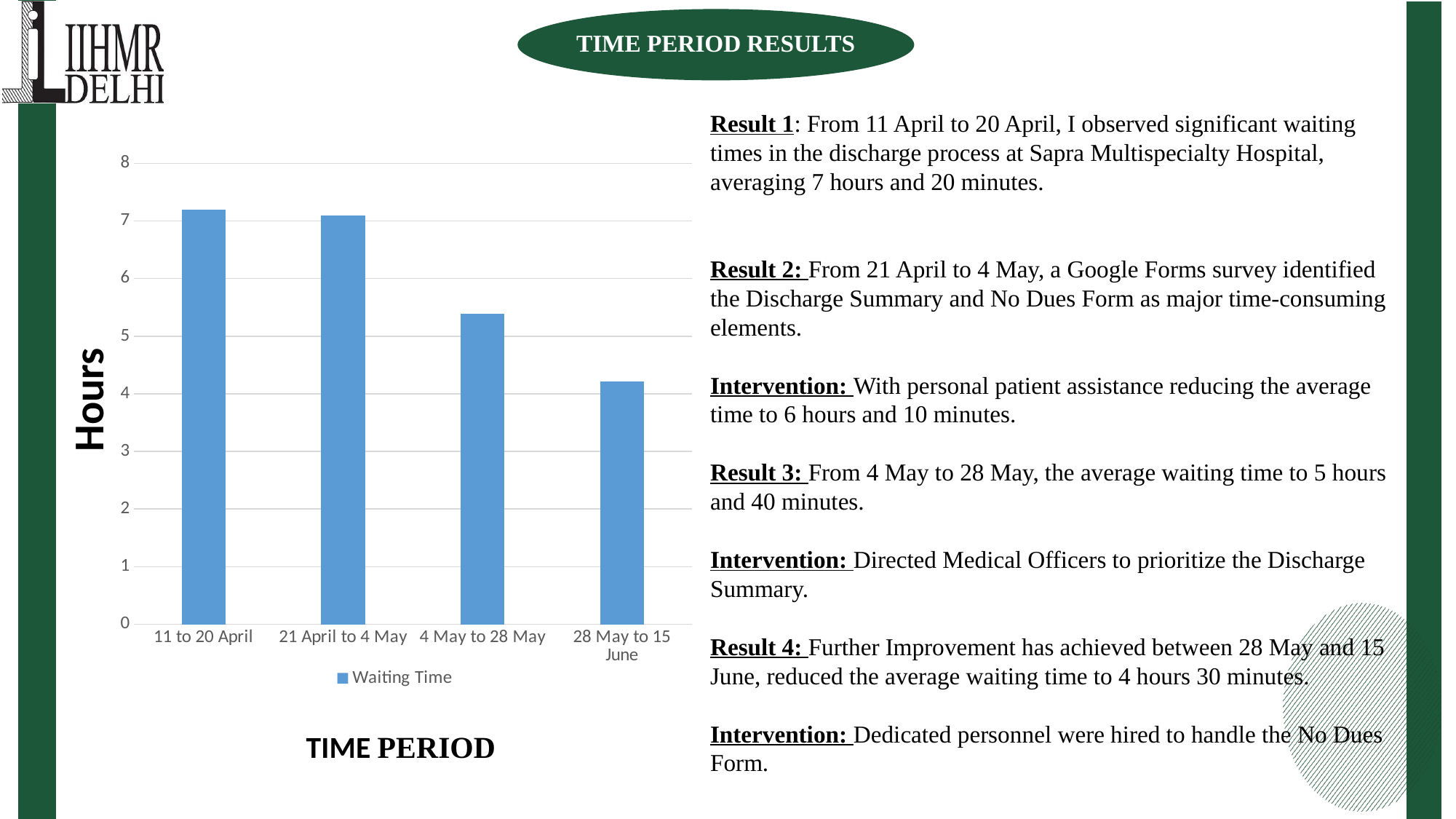
What is the label on the vertical axis of the chart? Hours How many time periods are plotted on the chart? 4 Which has a larger waiting time, 11 to 20 April or 4 May to 28 May? 11 to 20 April What is the name of the series shown in the chart legend? Waiting Time Is the waiting time for 28 May to 15 June greater or less than 4? greater What kind of chart is shown on the slide? bar chart Is the waiting time for 21 April to 4 May greater or less than 6? greater Do the waiting times rise or fall across the time periods from left to right? fall Is the waiting time for 4 May to 28 May greater or less than 6? less How many series does the chart legend list? 1 Which time period has the lowest waiting time? 28 May to 15 June